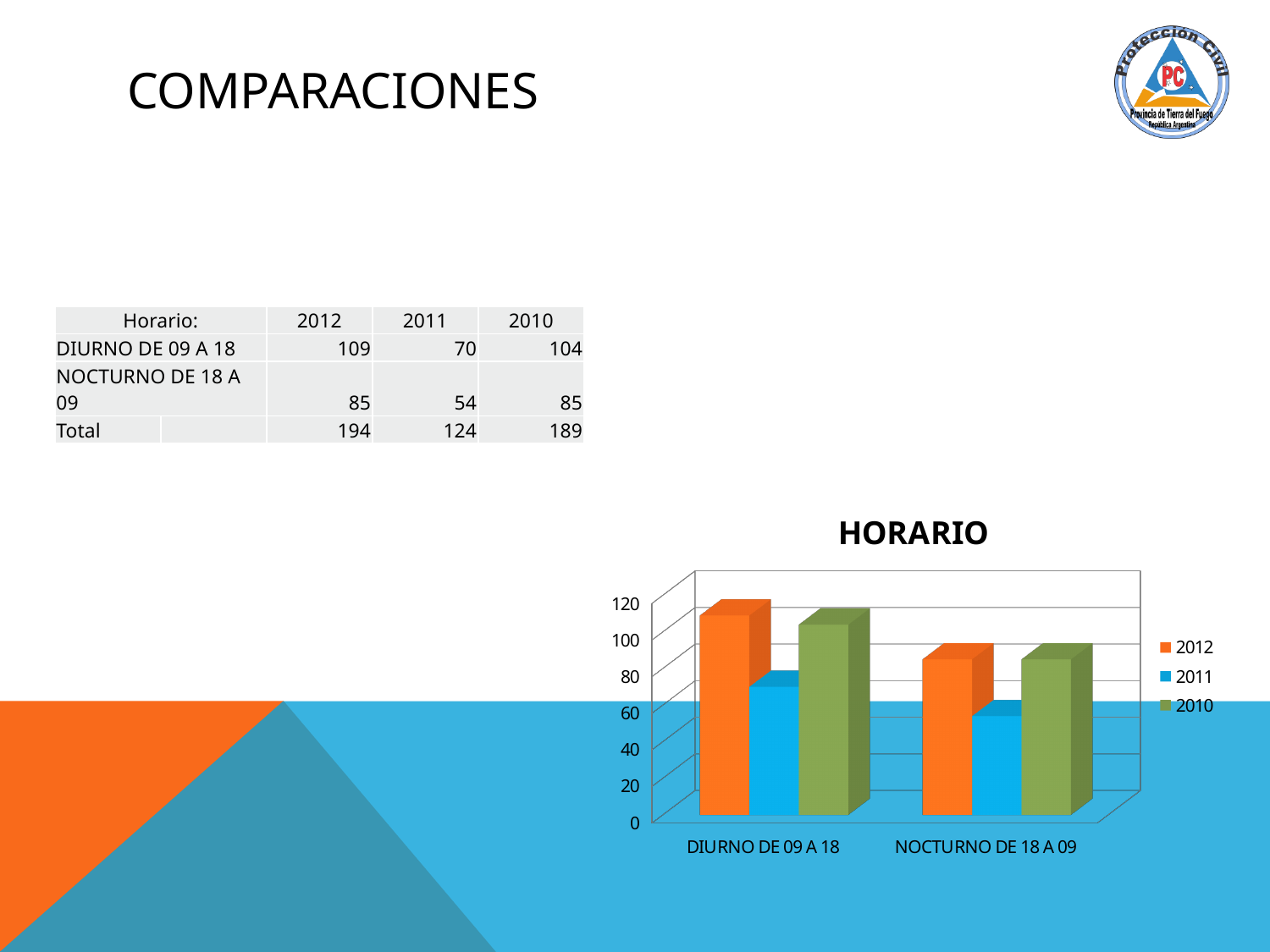
What is the difference between the 2012 and 2011 values for DIURNO DE 09 A 18? 39 Which series has the highest value in the DIURNO DE 09 A 18 category? 2012 Which series has the lowest value in the NOCTURNO DE 18 A 09 category? 2011 How many categories are shown on the x axis of the HORARIO chart? 2 What is the value for 2011 in the NOCTURNO DE 18 A 09 category? 54 What type of chart is shown under the title HORARIO? bar chart Is the 2011 value for DIURNO DE 09 A 18 greater or less than 80? less Which is larger, the 2012 value for NOCTURNO DE 18 A 09 or the 2011 value for DIURNO DE 09 A 18? 2012 value for NOCTURNO DE 18 A 09 What is the value for 2010 in the DIURNO DE 09 A 18 category? 104 What is the value for 2012 in the DIURNO DE 09 A 18 category? 109 What colour represents the 2011 series in the HORARIO chart? blue How many series does the legend of the HORARIO chart list? 3